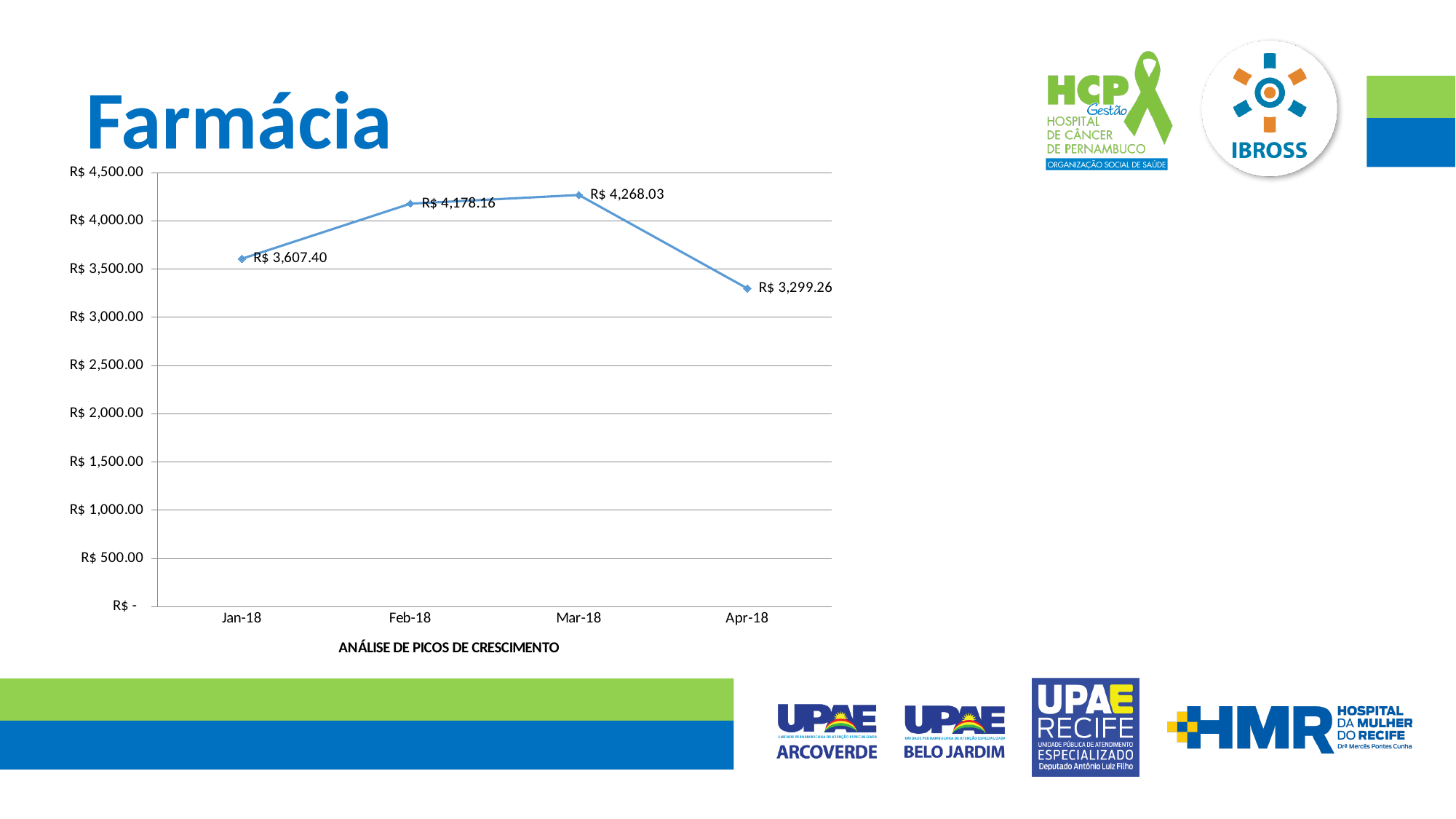
What is the difference between the values for Feb-18 and Jan-18? R$ 570.76 What is the title of the slide containing the chart? Farmácia What is the value for Jan-18? R$ 3,607.40 What is the value for Feb-18? R$ 4,178.16 Which is larger, the value for Jan-18 or the value for Apr-18? Jan-18 How many data points are plotted on the chart? 4 Which month has the highest value? Mar-18 What is the value for Mar-18? R$ 4,268.03 What is the value for Apr-18? R$ 3,299.26 What kind of chart is shown on the slide? Line chart Which month has the lowest value? Apr-18 What is the difference between the values for Mar-18 and Feb-18? R$ 89.87